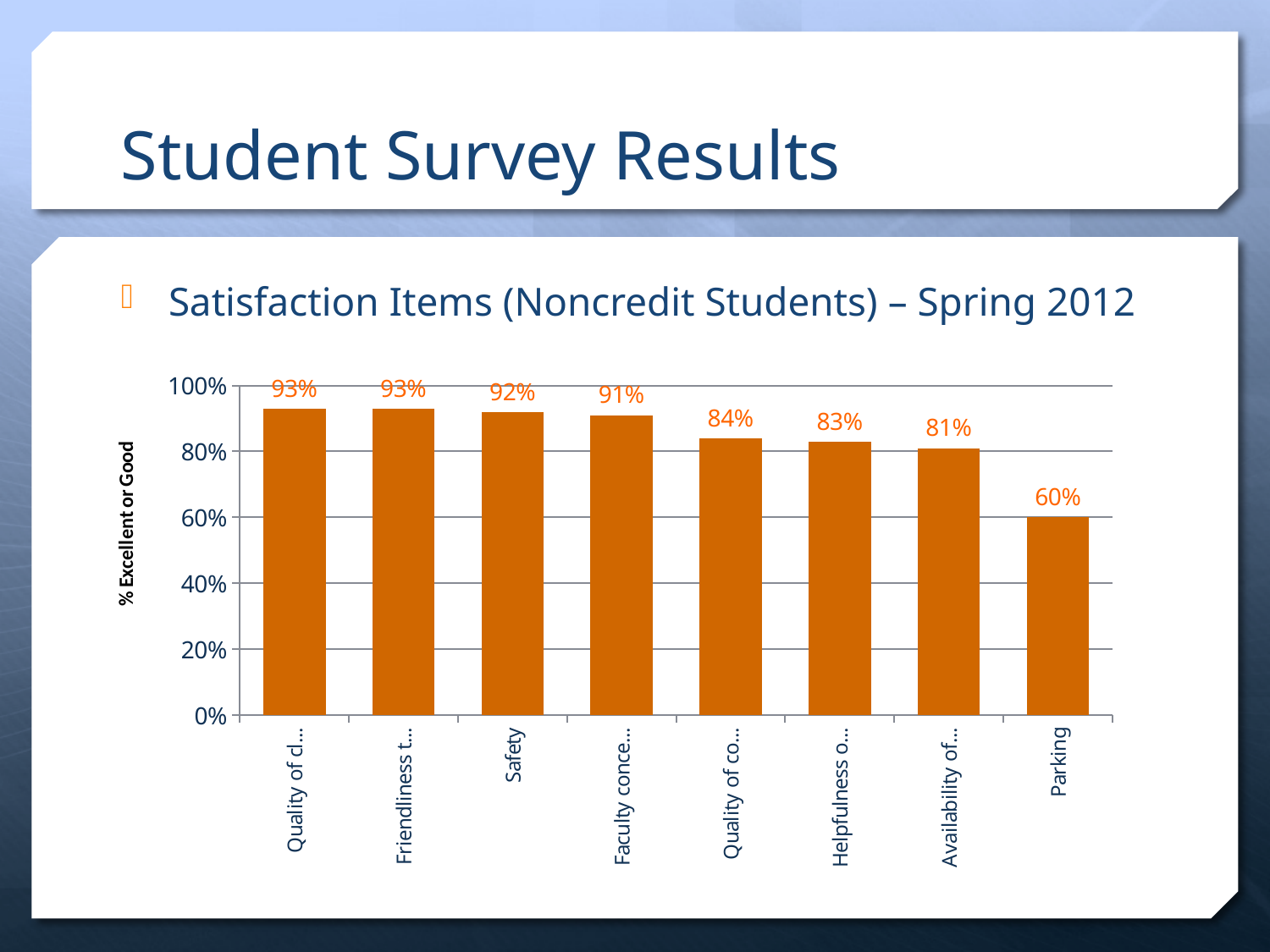
What kind of chart is shown on the slide? bar chart What is the value shown on the first (leftmost) bar? 93% Do the values generally rise or fall from left to right along the x axis? fall What is the difference between the values for Safety and Parking? 32% How many bars (categories) does the chart show? 8 What is the value for Parking? 60% Which is larger, the value for Safety or the value for Parking? Safety Which category has the lowest value? Parking What is the value for Safety? 92% Is the value for Safety greater or less than 80%? greater What is the label of the vertical axis? % Excellent or Good Is the value for Parking greater or less than 80%? less